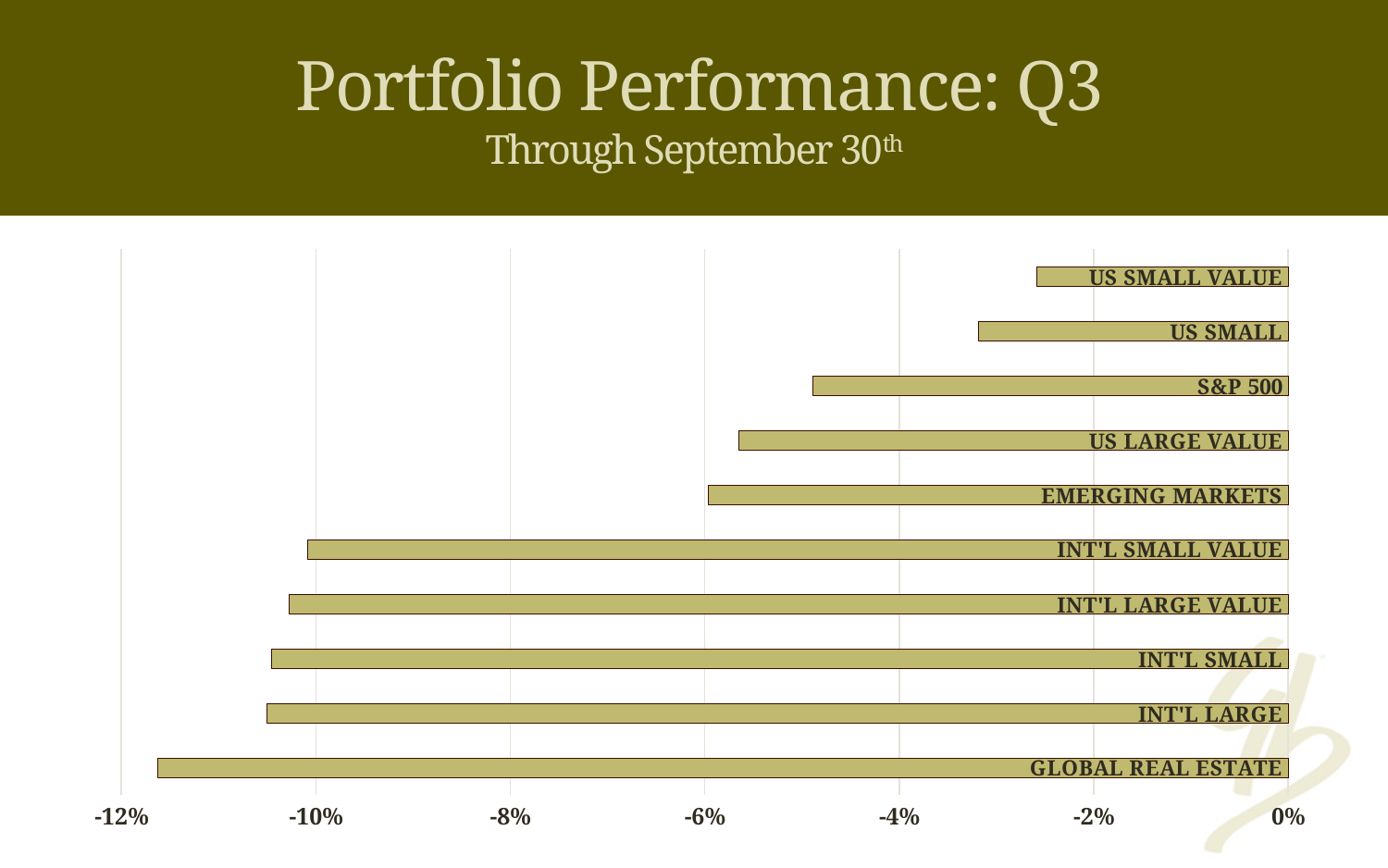
Is the value for Int'l Small Value greater or less than -8%? less How many categories are plotted in the chart? 10 What is the lowest value shown on the horizontal axis? -12% Which has the larger value, US Small or S&P 500? US Small Which has the larger value, Emerging Markets or Int'l Large? Emerging Markets Is the value for S&P 500 greater or less than -4%? less Which category has the lowest (most negative) value? Global Real Estate Is the value for US Small Value greater or less than -4%? greater What is the title of the slide containing the chart? Portfolio Performance: Q3 What kind of chart is shown on the slide? Bar chart Which category has the highest (least negative) value? US Small Value